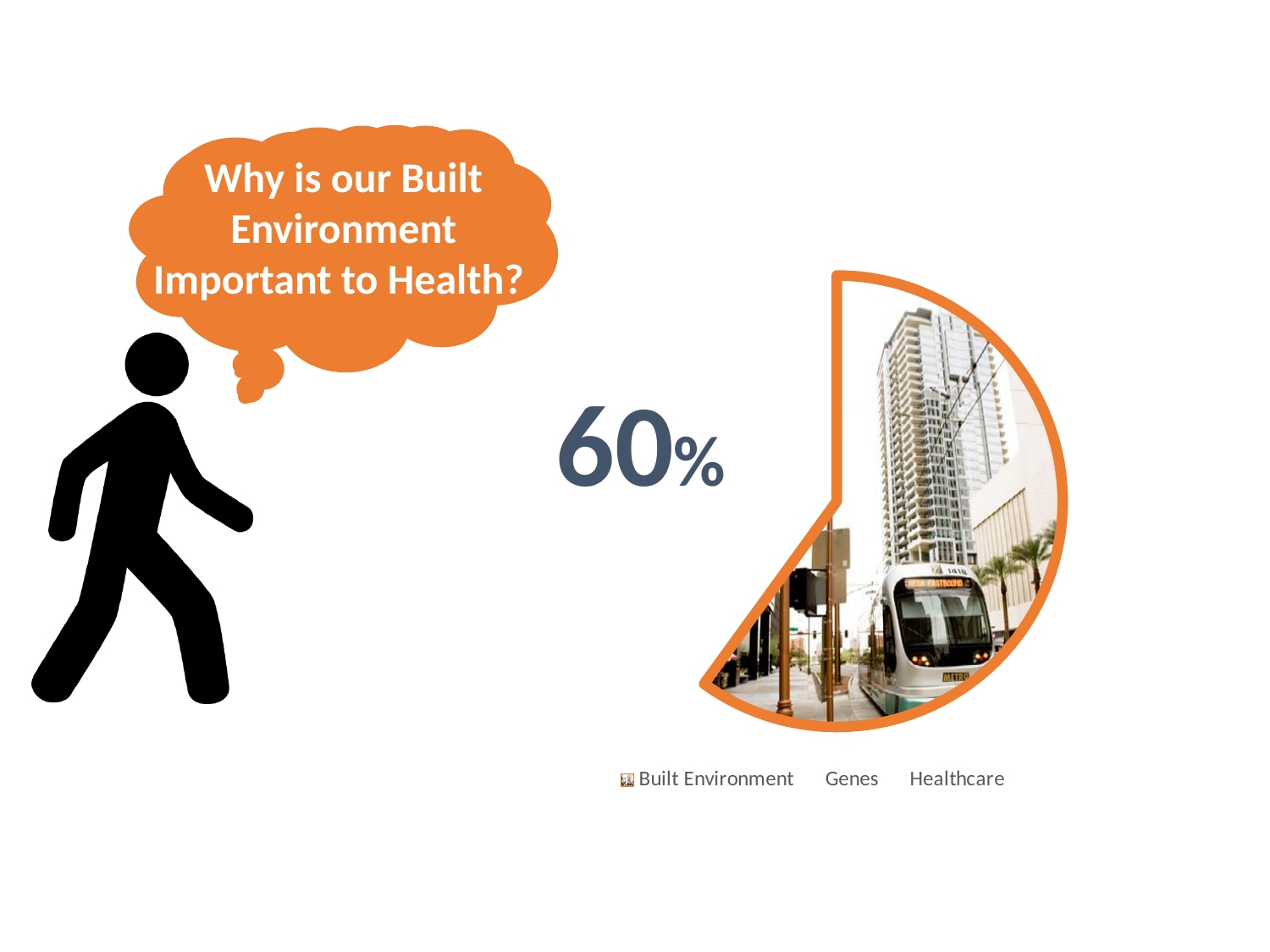
How many categories does the pie chart's legend list? 3 Which category is the largest slice of the pie chart? Built Environment What percentage is shown for the Built Environment slice of the pie chart? 60% Is the value for Built Environment greater or less than 50%? greater What kind of chart is shown on the right side of the slide? pie chart What are the three categories listed in the pie chart's legend? Built Environment, Genes, Healthcare What share of the pie does the Built Environment slice represent? 60% Which pie slice is filled with a photograph of a city street and light rail train? Built Environment